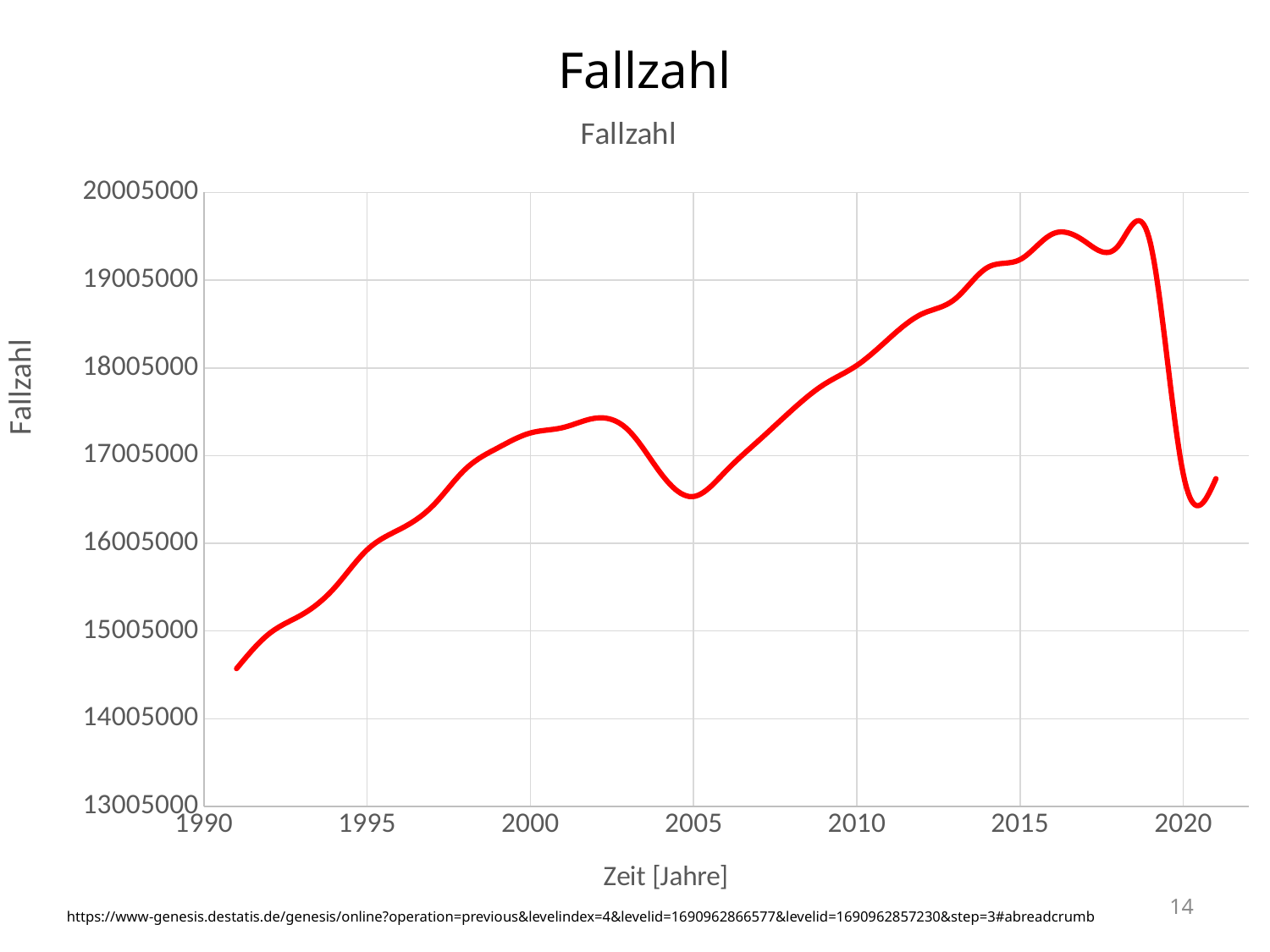
What kind of chart is shown on the slide? line chart Do the values rise or fall between 1990 and 2000? rise Is the value for 2005 greater or less than 17005000? less Is the value at the start of the line (around 1991) greater or less than 15005000? less Do the values rise or fall between 2019 and 2020? fall Is the value for 2000 greater or less than 17005000? greater What is the label of the x axis? Zeit [Jahre] Which is larger, the value for 2015 or the value for 2005? 2015 What is the title of the chart? Fallzahl How many lines are plotted on the chart? 1